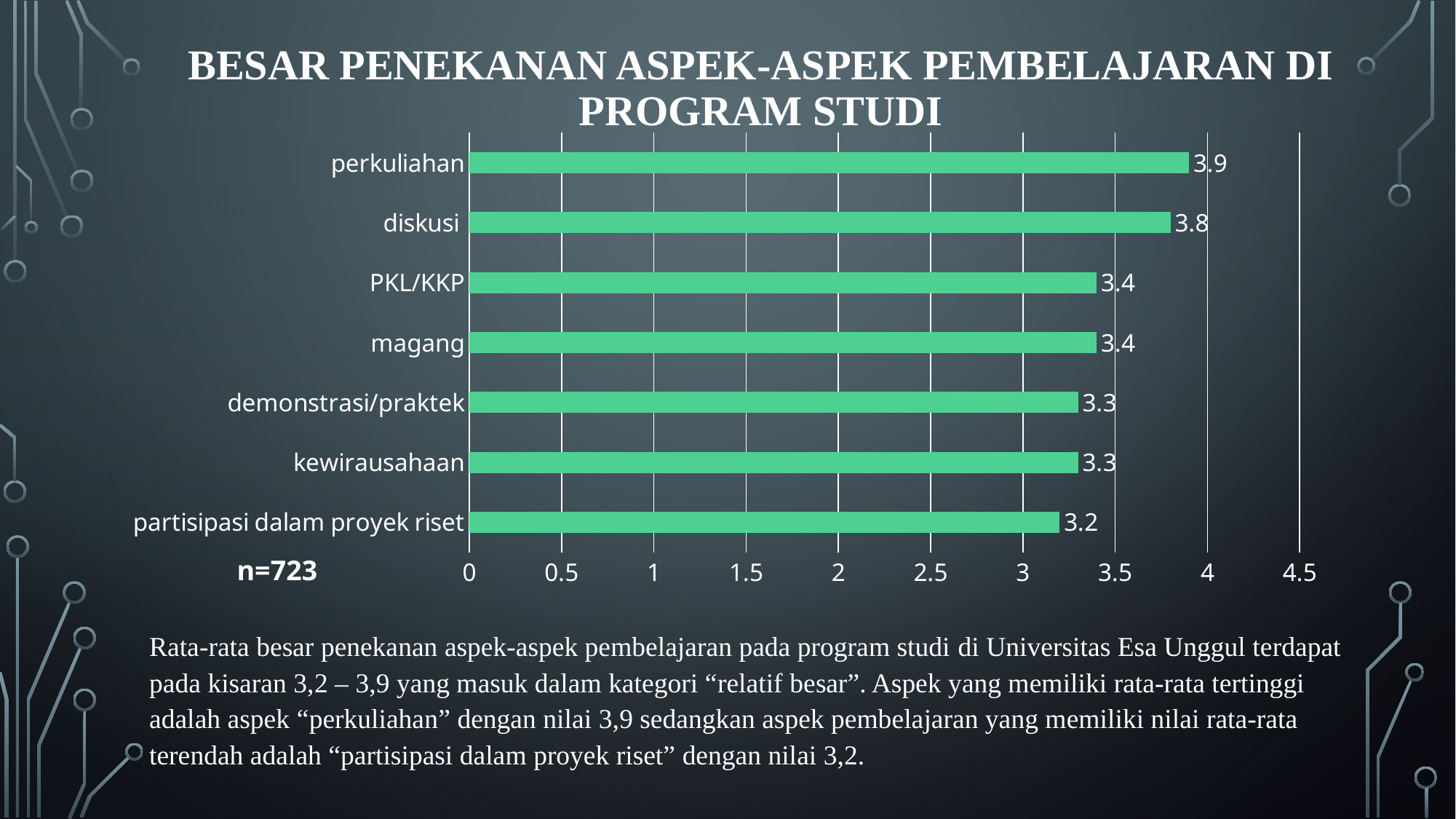
What kind of chart is shown on the slide? bar chart Which category has the highest value? perkuliahan What is the difference between the values for perkuliahan and partisipasi dalam proyek riset? 0.7 What is the value for diskusi? 3.8 Which category has the lowest value? partisipasi dalam proyek riset What is the value for perkuliahan? 3.9 Which is larger, the value for diskusi or the value for magang? diskusi What sample size (n) is shown below the chart? n=723 What is the value for PKL/KKP? 3.4 What is the value for partisipasi dalam proyek riset? 3.2 Is the value for kewirausahaan greater or less than 3.5? less How many categories are shown in the chart? 7